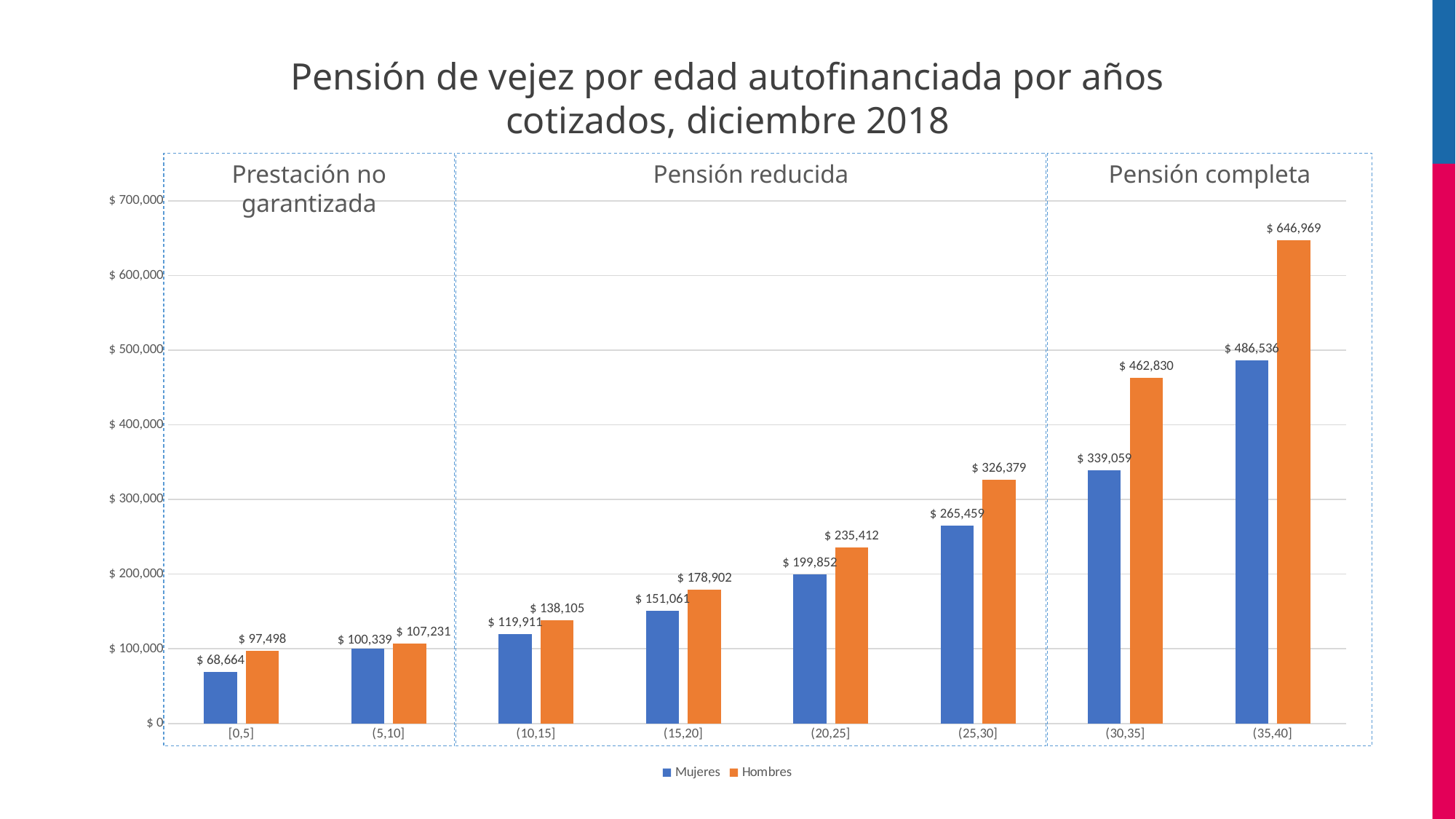
Which category has the lowest value for Hombres? [0,5] What kind of chart is shown on the slide? Bar chart Is the value for Hombres in the (25,30] category greater or less than $ 300,000? greater How many categories are shown on the x axis? 8 What is the difference between Hombres and Mujeres in the (35,40] category? $ 160,433 Which is larger in the (30,35] category, Mujeres or Hombres? Hombres What is the value for Hombres in the (35,40] category? $ 646,969 Which category has the highest value for Mujeres? (35,40] What is the value for Hombres in the (15,20] category? $ 178,902 How many series does the legend list? 2 What is the value for Mujeres in the [0,5] category? $ 68,664 What is the value for Mujeres in the (20,25] category? $ 199,852